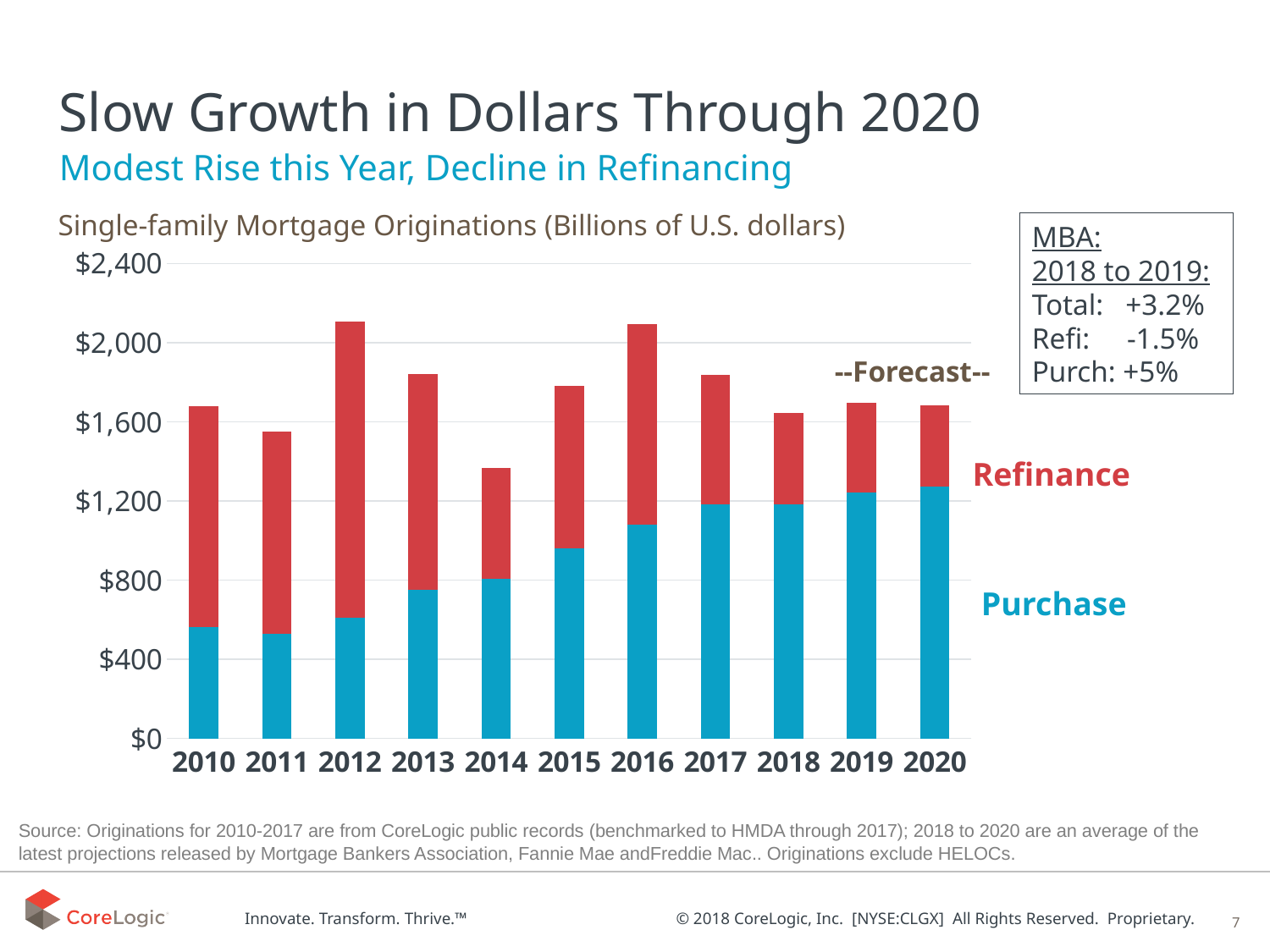
What kind of chart is shown on the slide? Stacked bar chart Is the total originations value for 2014 greater or less than $1,600? less Is the Purchase value for 2020 greater or less than $1,200? greater Which years on the chart are labeled as forecast? 2018, 2019 and 2020 Does the Purchase segment generally rise or fall from 2010 to 2020? rise Is the Purchase value for 2010 greater or less than $800? less Which year has the lowest total single-family mortgage originations? 2014 How many series does the chart show? 2 Which year has the largest Refinance segment? 2012 How many years are shown on the x axis of the chart? 11 Which year has the larger total originations, 2012 or 2014? 2012